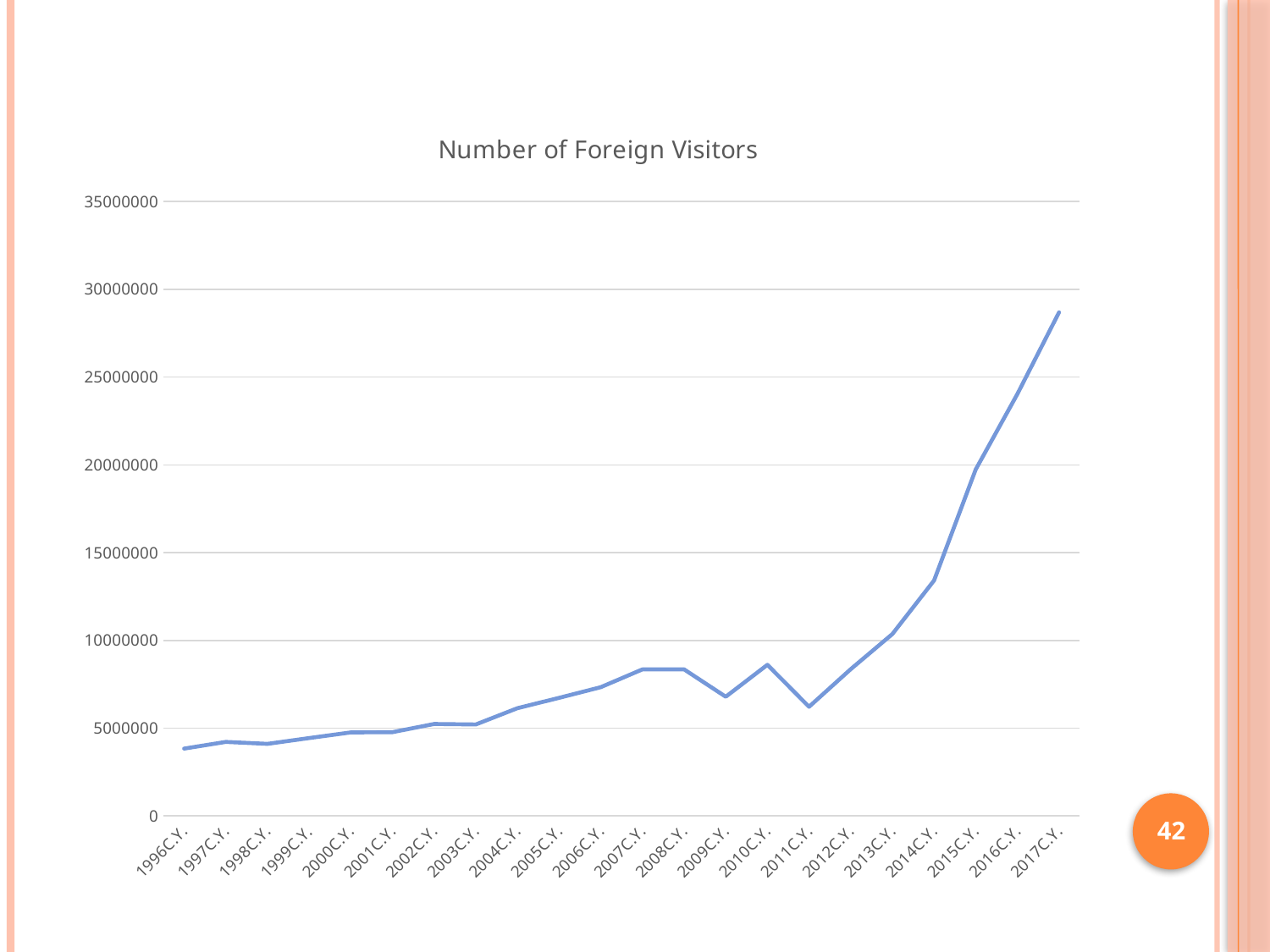
Is the value for 2007C.Y. greater or less than 10000000? less How many years are plotted along the x axis of the chart? 22 Is the value for 1996C.Y. greater or less than 5000000? less Is the value for 2014C.Y. greater or less than 15000000? less Which year has the larger number of foreign visitors, 2010C.Y. or 2011C.Y.? 2010C.Y. Overall, does the number of foreign visitors rise or fall from 1996C.Y. to 2017C.Y.? rise Does the number of foreign visitors rise or fall from 2008C.Y. to 2009C.Y.? fall Which year has the highest number of foreign visitors? 2017C.Y. What kind of chart is shown on the slide? line chart What is the title of the chart? Number of Foreign Visitors